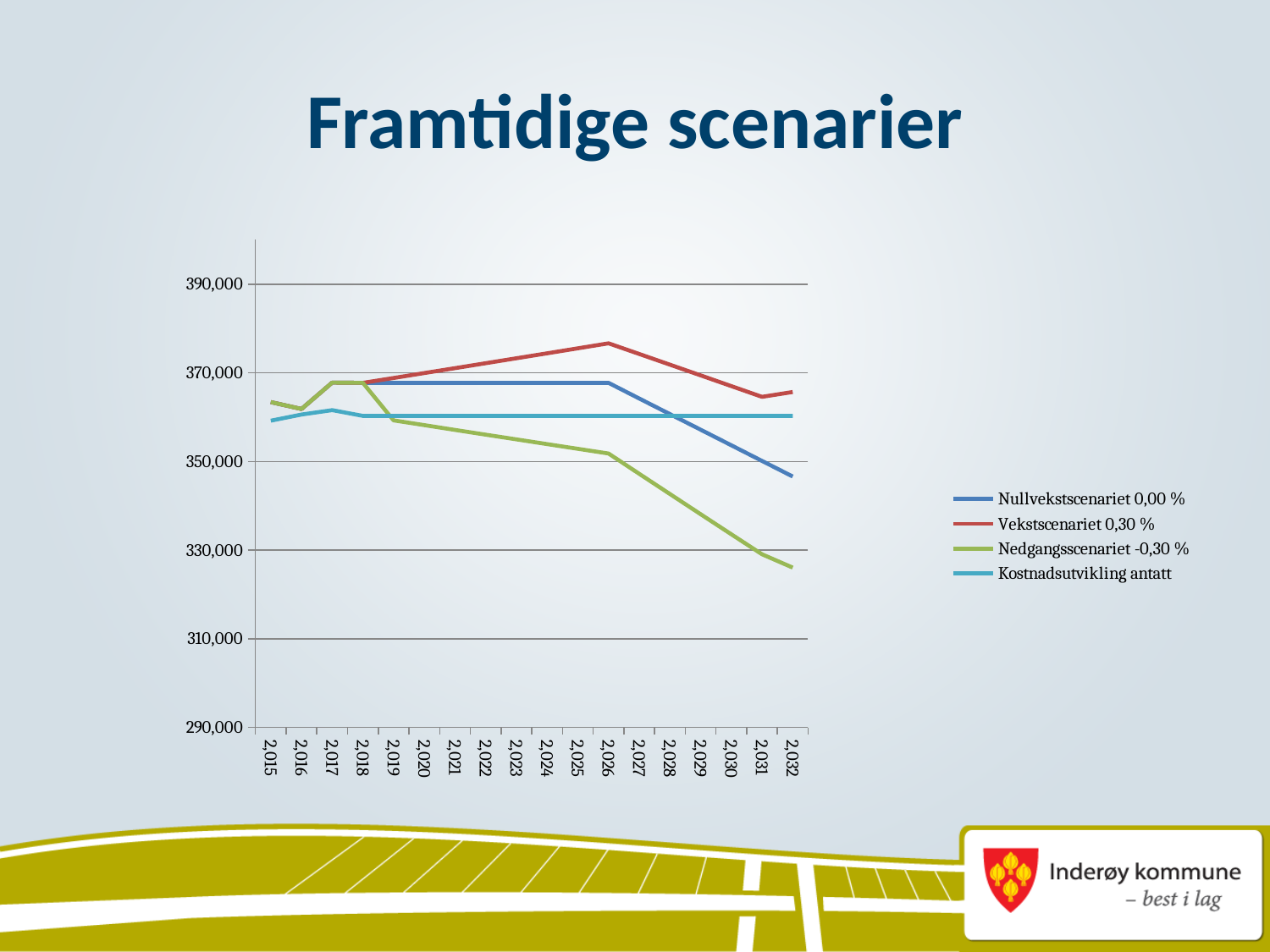
Which series has the lowest value in 2032? Nedgangsscenariet -0,30 % What is the title of the slide? Framtidige scenarier Which series has the highest value in 2032? Vekstscenariet 0,30 % How many years are shown along the x axis? 18 Is the value for Nullvekstscenariet 0,00 % in 2032 greater or less than 350,000? less What kind of chart is shown on the slide? line chart Does the Nedgangsscenariet -0,30 % line rise or fall from 2018 to 2032? fall Which series is drawn in red? Vekstscenariet 0,30 % In 2032, which is larger: Nullvekstscenariet 0,00 % or Kostnadsutvikling antatt? Kostnadsutvikling antatt Is the value for Vekstscenariet 0,30 % in 2026 greater or less than 370,000? greater Is the value for Nedgangsscenariet -0,30 % in 2032 greater or less than 330,000? less How many series does the legend list? 4